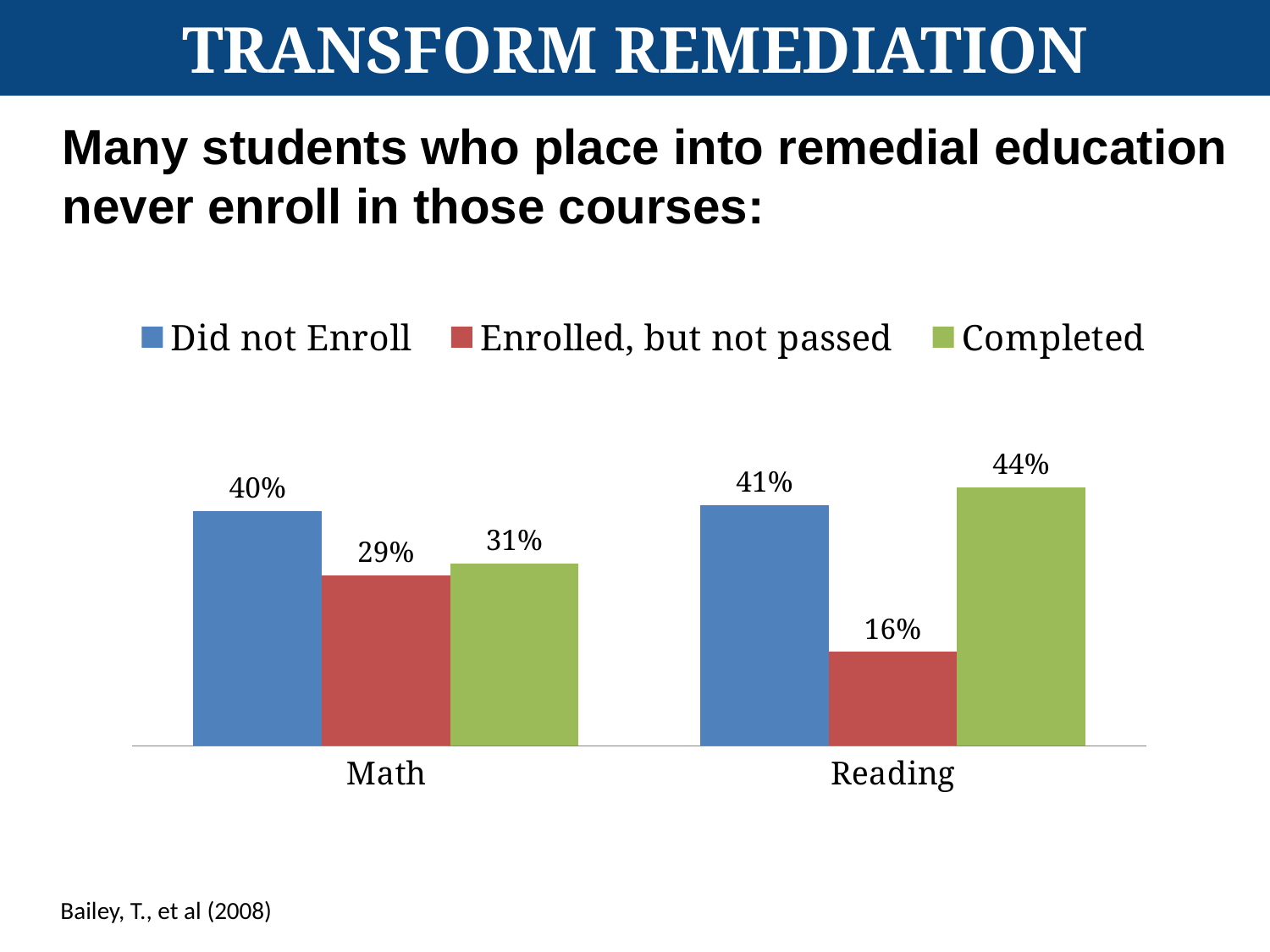
What percentage of Math students did not enroll? 40% What is the difference between Enrolled, but not passed for Math and for Reading? 13% How many categories are shown on the x axis? 2 Which is larger: Completed for Math or Completed for Reading? Completed for Reading Which series has the highest value for Reading? Completed How many series does the legend list? 3 What is the difference between Did not Enroll and Completed for Math? 9% What is the value for Completed in Reading? 44% What colour represents the Completed series? Green Which series has the lowest value for Math? Enrolled, but not passed What kind of chart is shown on the slide? Bar chart What is the value for Enrolled, but not passed in Reading? 16%